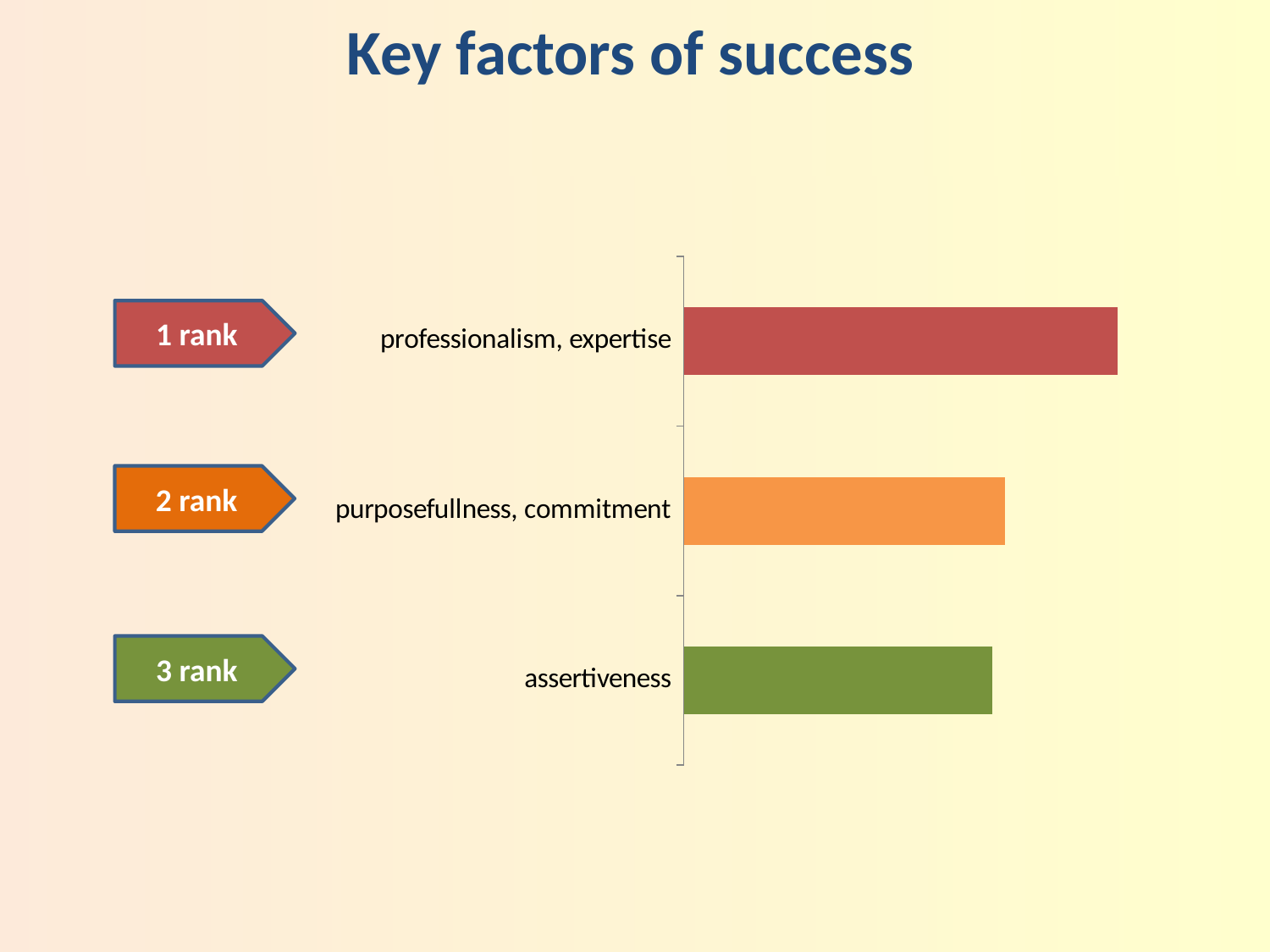
What colour is the bar for assertiveness? green Which is larger, the value for professionalism, expertise or the value for assertiveness? professionalism, expertise What kind of chart is shown on the slide? bar chart Which category is labelled as 3 rank on the slide? assertiveness What is the title of the slide containing the chart? Key factors of success Which category is labelled as 2 rank on the slide? purposefullness, commitment Which category has the longest bar in the chart? professionalism, expertise Which is larger, the value for professionalism, expertise or the value for purposefullness, commitment? professionalism, expertise Which category is labelled as 1 rank on the slide? professionalism, expertise How many categories does the bar chart show? 3